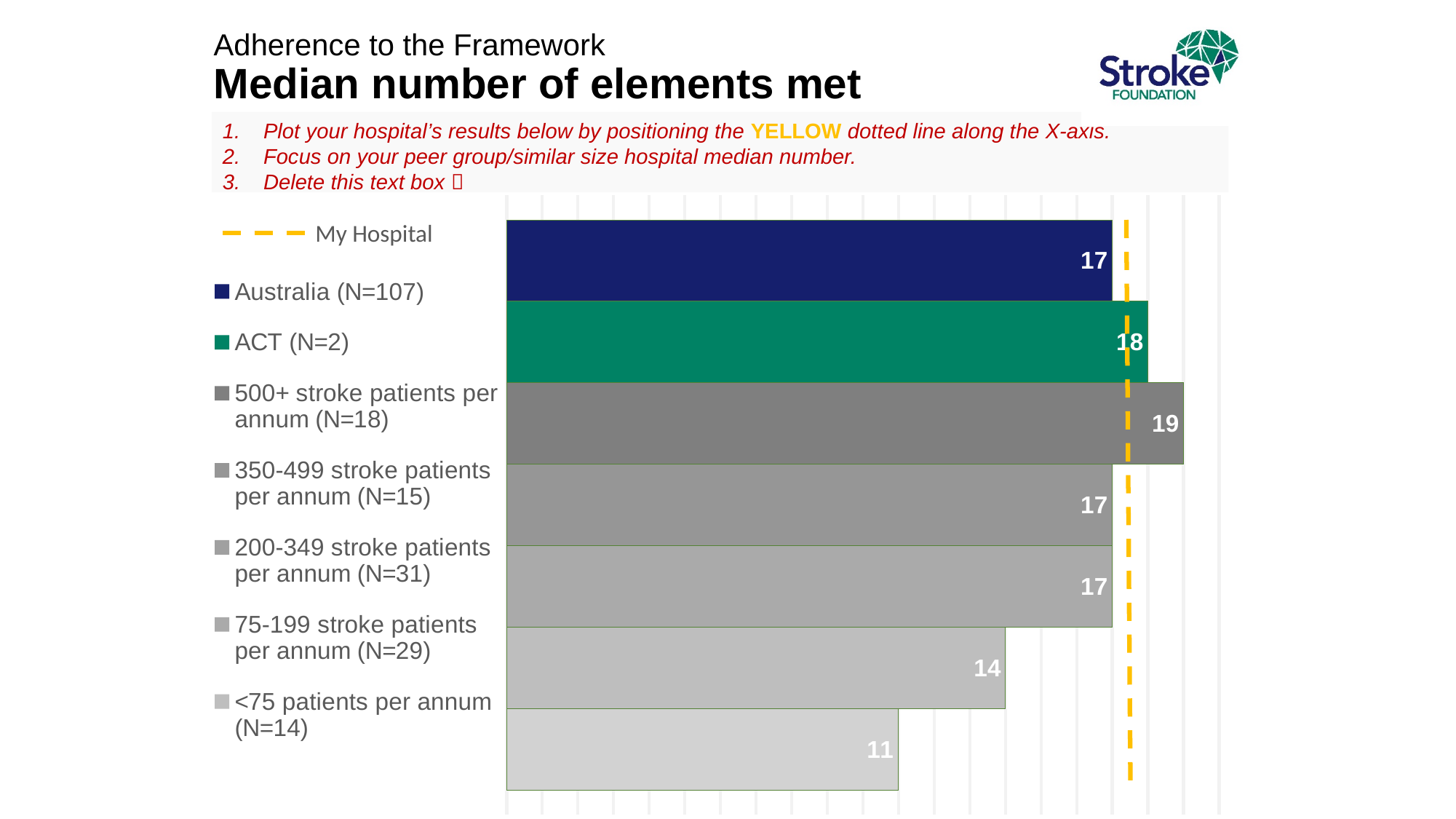
Which group has the lowest median number of elements met? <75 patients per annum (N=14) What is the median number of elements met for hospitals with 500+ stroke patients per annum (N=18)? 19 What is the median number of elements met for Australia (N=107)? 17 What is the difference between the median for 500+ stroke patients per annum and the median for <75 patients per annum? 8 How many bars are plotted in the chart? 7 Which group has the highest median number of elements met? 500+ stroke patients per annum (N=18) Which has a higher median number of elements met: ACT (N=2) or Australia (N=107)? ACT (N=2) What type of chart is shown on the slide? Bar chart What is the median number of elements met for hospitals with <75 patients per annum (N=14)? 11 What is the median number of elements met for hospitals with 75-199 stroke patients per annum (N=29)? 14 What colour is the bar for ACT (N=2)? Green What is the median number of elements met for ACT (N=2)? 18